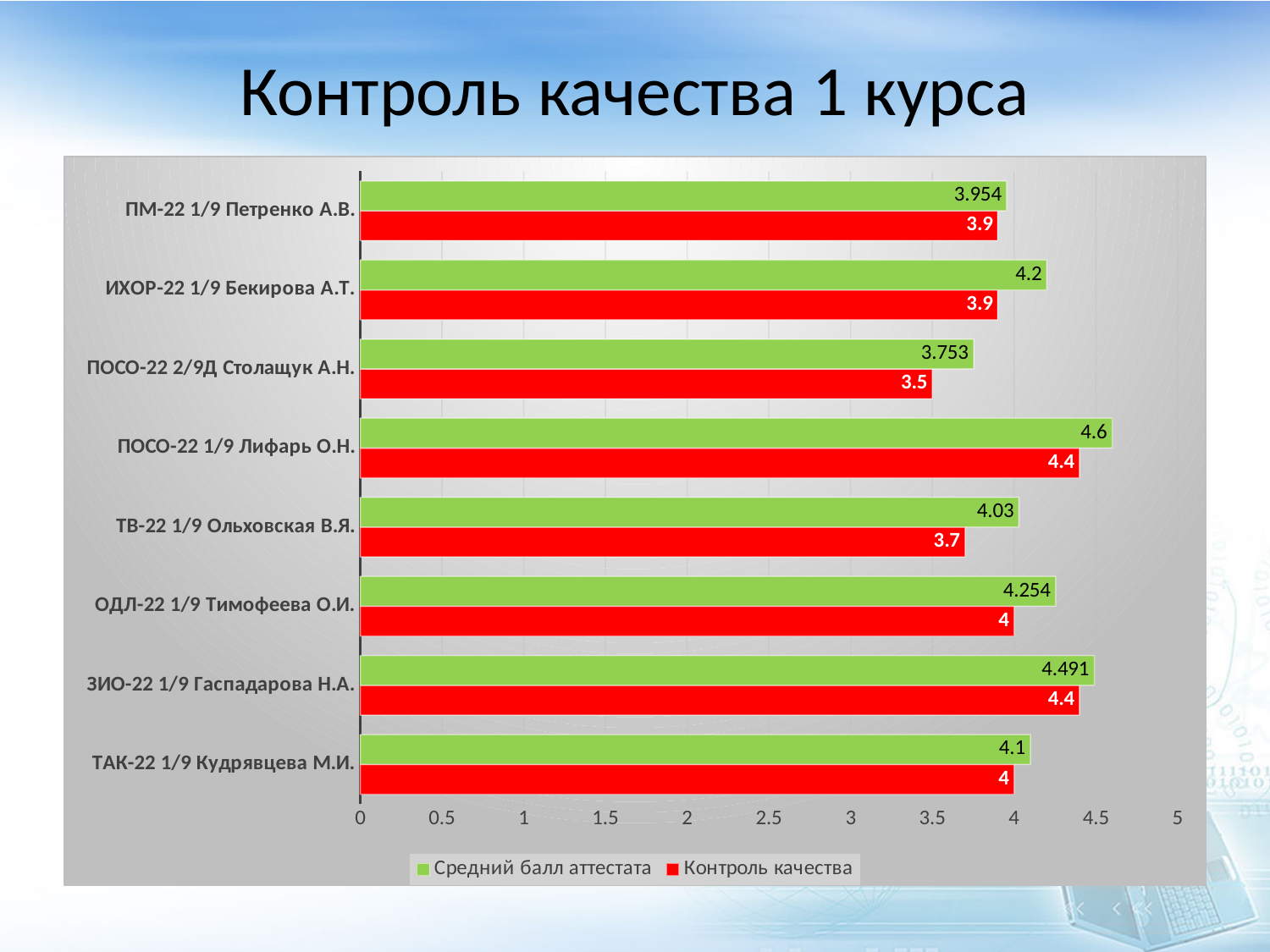
What is the Средний балл аттестата value for ЗИО-22 1/9 Гаспадарова Н.А.? 4.491 What is the Средний балл аттестата value for ПОСО-22 1/9 Лифарь О.Н.? 4.6 How many series does the legend list? 2 What type of chart is shown on the slide? Bar chart How many groups are shown on the chart? 8 What is the difference between the Средний балл аттестата and Контроль качества values for ИХОР-22 1/9 Бекирова А.Т.? 0.3 Which group has the lowest Контроль качества value? ПОСО-22 2/9Д Столащук А.Н. Is the Средний балл аттестата value for ПМ-22 1/9 Петренко А.В. greater or less than 4? less Which is larger: the Контроль качества value for ОДЛ-22 1/9 Тимофеева О.И. or for ТВ-22 1/9 Ольховская В.Я.? ОДЛ-22 1/9 Тимофеева О.И. What is the Контроль качества value for ТВ-22 1/9 Ольховская В.Я.? 3.7 Which group has the highest Средний балл аттестата? ПОСО-22 1/9 Лифарь О.Н. Which colour represents the Контроль качества series? Red